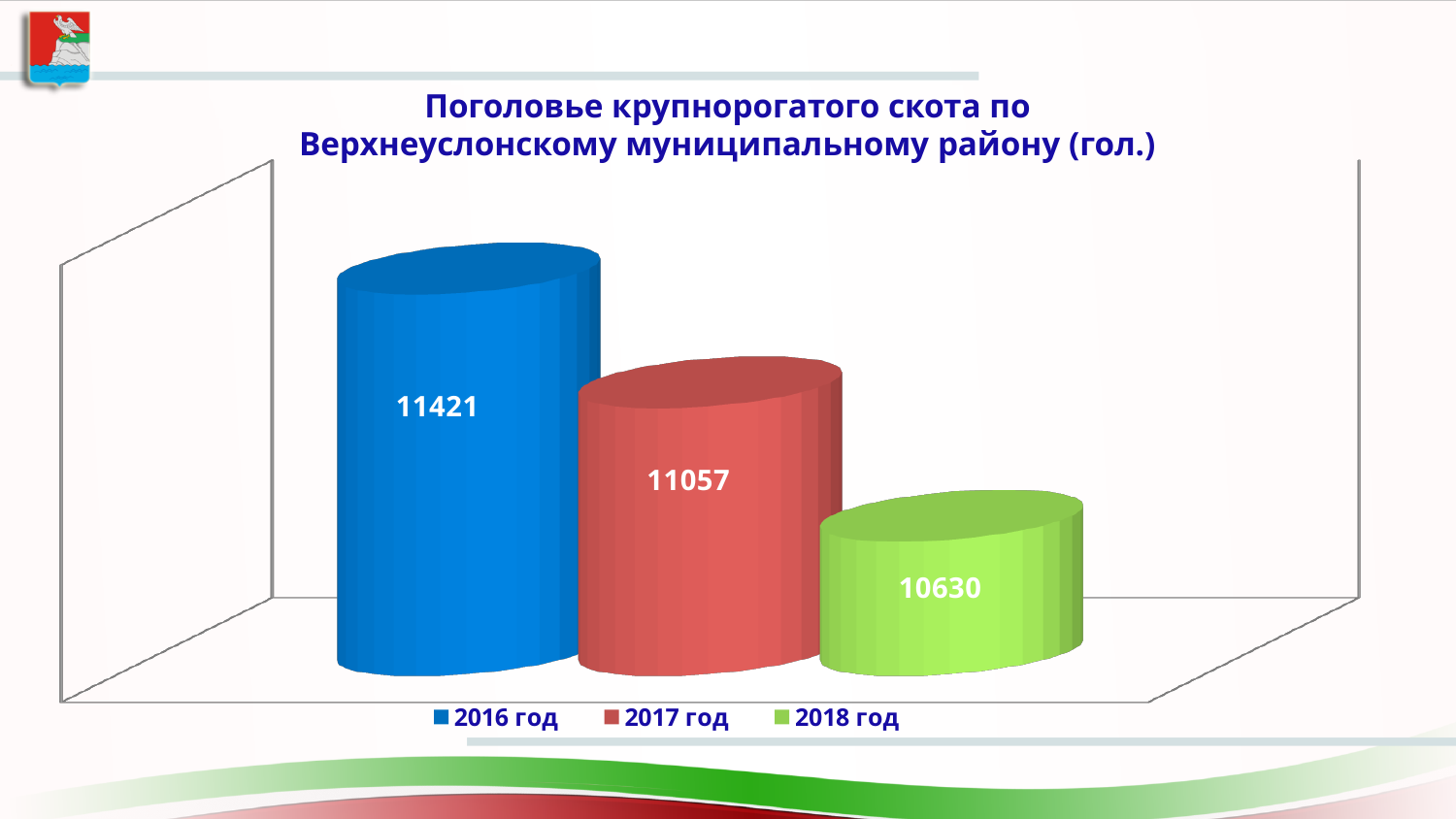
What is the difference between the 2016 год and 2018 год values? 791 Do the values rise or fall from 2016 год to 2018 год? fall What is the cattle headcount for 2016 год? 11421 What is the difference between the 2017 год and 2018 год values? 427 What is the difference between the 2016 год and 2017 год values? 364 Which year has the lowest cattle headcount? 2018 год Which year has the highest cattle headcount? 2016 год Which is larger, the value for 2017 год or the value for 2018 год? 2017 год What kind of chart is shown on the slide? bar chart What is the cattle headcount for 2017 год? 11057 What is the cattle headcount for 2018 год? 10630 How many series does the legend list? 3